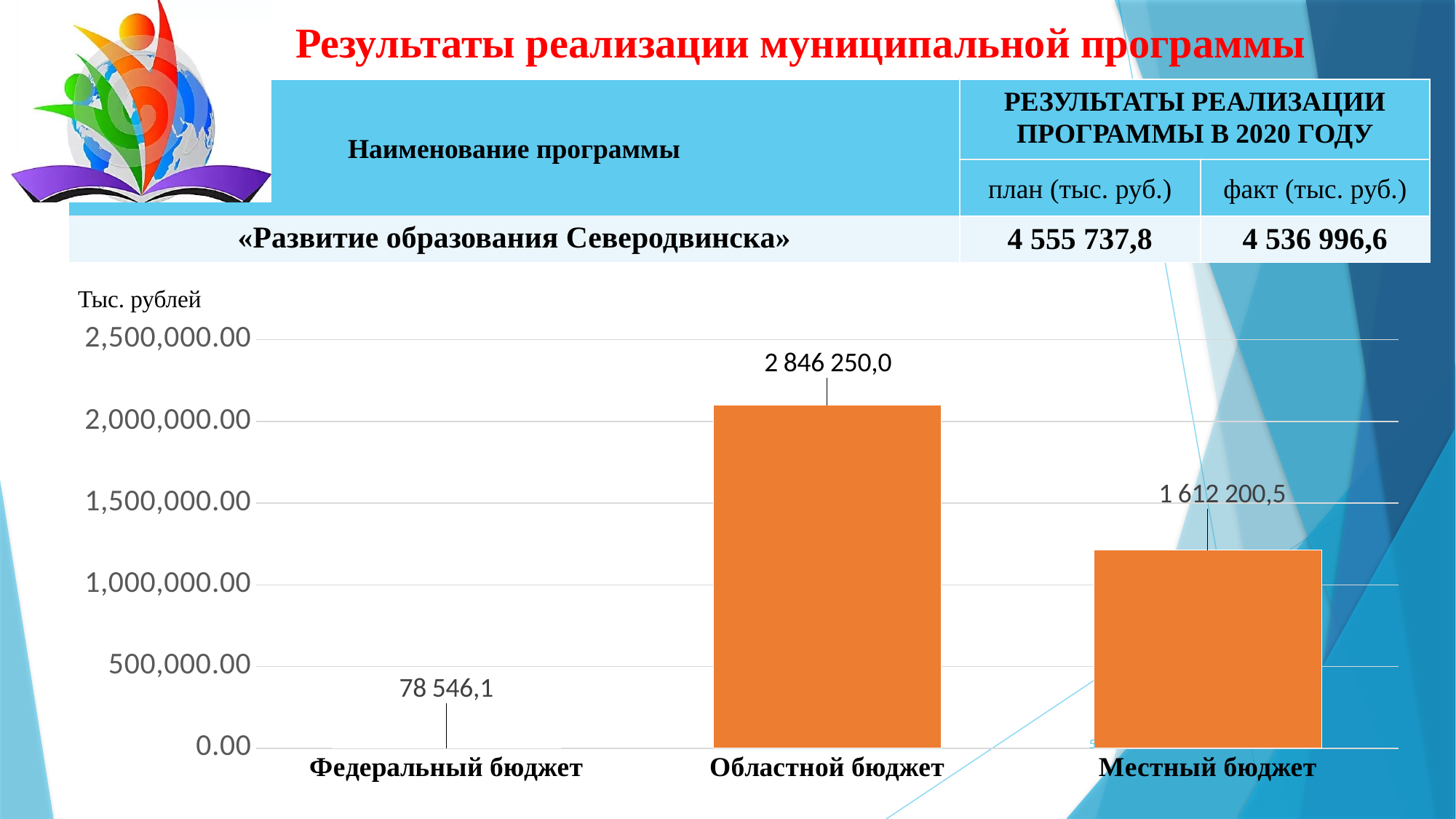
Which budget category has the lowest value? Федеральный бюджет What is the difference between the values for Областной бюджет and Федеральный бюджет? 2 767 703,9 Which budget category has the highest value? Областной бюджет What is the difference between the values for Областной бюджет and Местный бюджет? 1 234 049,5 What kind of chart is shown on the slide? bar chart What is the value for Областной бюджет? 2 846 250,0 Which is larger, the value for Местный бюджет or the value for Федеральный бюджет? Местный бюджет What is the value for Местный бюджет? 1 612 200,5 What unit is indicated above the vertical axis of the chart? Тыс. рублей Is the value for Федеральный бюджет greater or less than 500,000.00? less What is the value for Федеральный бюджет? 78 546,1 How many budget categories are shown in the chart? 3